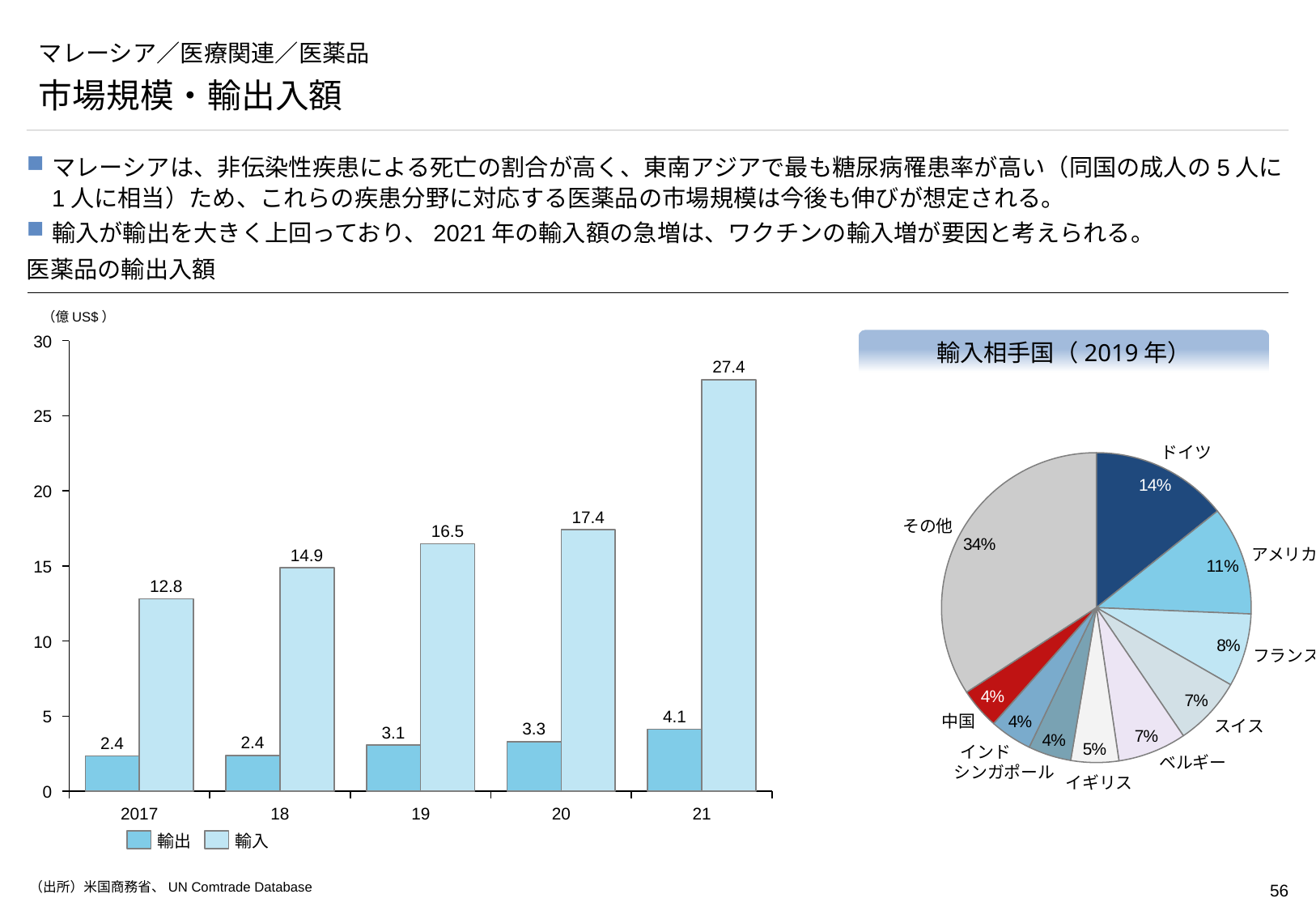
In the bar chart 医薬品の輸出入額, which year has the highest 輸入 value? 2021 In the pie chart 輸入相手国（2019年）, which is larger, アメリカ or フランス? アメリカ In the bar chart 医薬品の輸出入額, what is the 輸入 value for 2021? 27.4 In the bar chart 医薬品の輸出入額, how many series does the legend list? 2 In the bar chart 医薬品の輸出入額, what is the difference between 輸入 and 輸出 in 2020? 14.1 What kind of chart is 医薬品の輸出入額? bar chart In the pie chart 輸入相手国（2019年）, what share does ドイツ have? 14% In the bar chart 医薬品の輸出入額, what is the 輸出 value for 2019? 3.1 In the bar chart 医薬品の輸出入額, does the 輸入 value rise or fall from 2017 to 2021? rise In the bar chart 医薬品の輸出入額, how many years are shown on the x axis? 5 In the pie chart 輸入相手国（2019年）, how many slices are there? 10 In the pie chart 輸入相手国（2019年）, which named country has the largest share? ドイツ